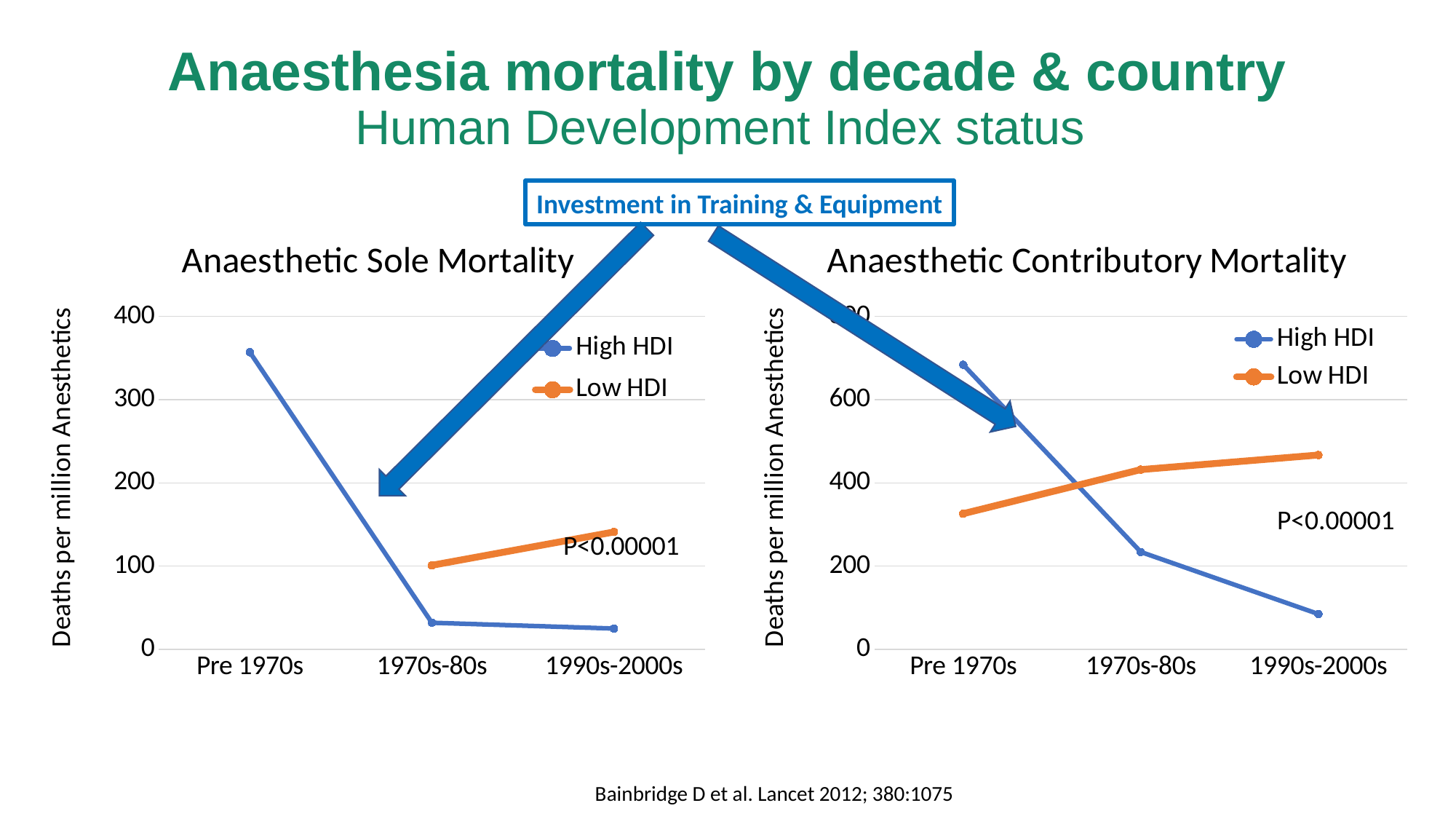
What is the y-axis label of the Anaesthetic Contributory Mortality chart? Deaths per million Anesthetics In the Anaesthetic Sole Mortality chart, is the High HDI value for Pre 1970s greater or less than 300? greater In the Anaesthetic Contributory Mortality chart, which series has the higher value for Pre 1970s, High HDI or Low HDI? High HDI In the Anaesthetic Sole Mortality chart, is the Low HDI value for 1990s-2000s greater or less than 100? greater How many series does the legend of the Anaesthetic Contributory Mortality chart list? 2 In the Anaesthetic Sole Mortality chart, which series has the higher value for 1990s-2000s, High HDI or Low HDI? Low HDI In the Anaesthetic Contributory Mortality chart, is the High HDI value for Pre 1970s greater or less than 600? greater In the Anaesthetic Sole Mortality chart, does the High HDI line rise or fall from Pre 1970s to 1990s-2000s? Fall In the Anaesthetic Contributory Mortality chart, does the Low HDI line rise or fall from Pre 1970s to 1990s-2000s? Rise What kind of chart is the Anaesthetic Sole Mortality chart? Line chart How many decade categories are shown on the x axis of the Anaesthetic Sole Mortality chart? 3